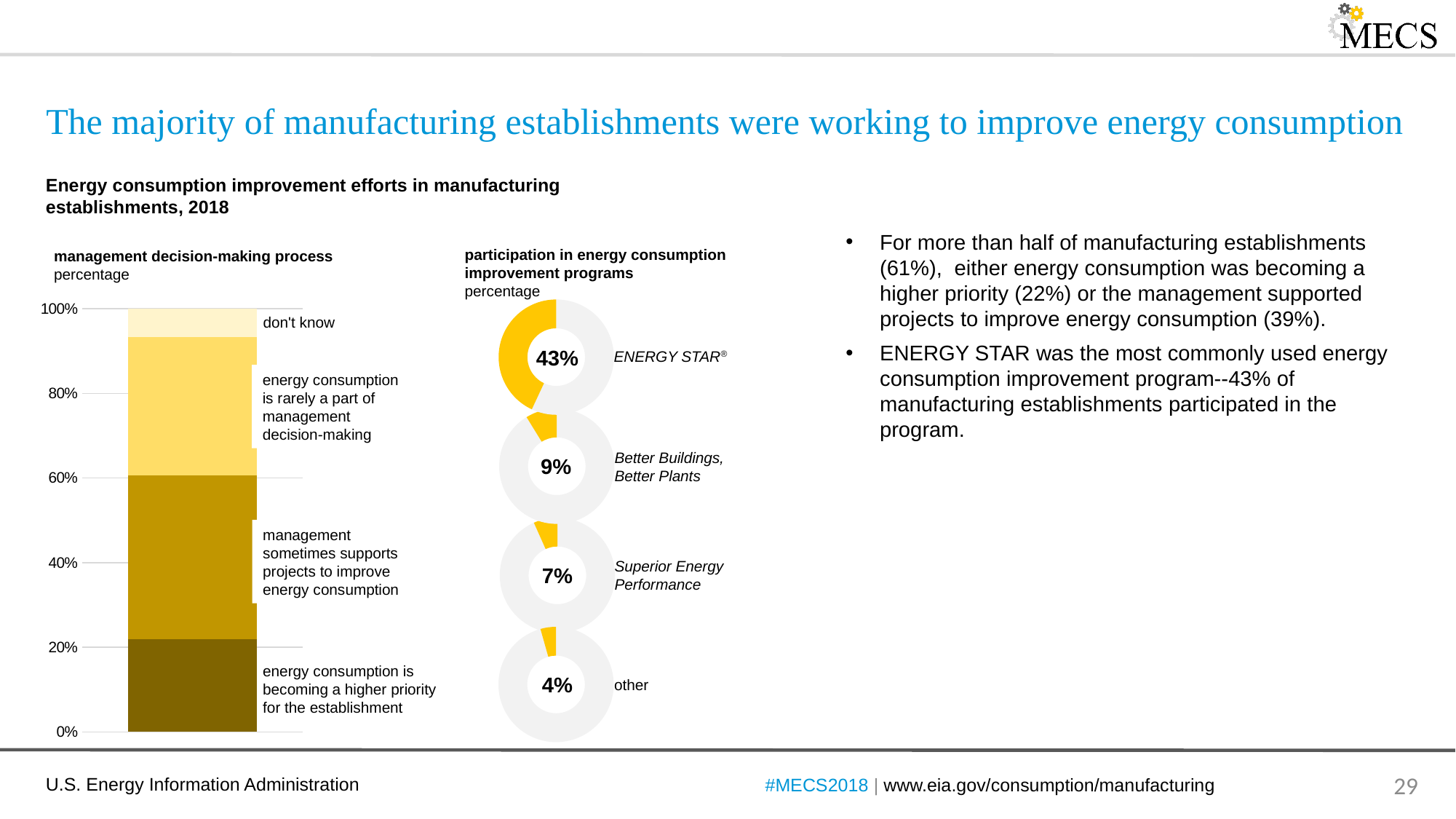
In the participation in energy consumption improvement programs chart, what is the value for Better Buildings, Better Plants? 9% In the participation in energy consumption improvement programs chart, which is larger: Superior Energy Performance or Better Buildings, Better Plants? Better Buildings, Better Plants What kind of chart is the management decision-making process chart? stacked bar chart How many segments make up the bar in the management decision-making process chart? 4 In the participation in energy consumption improvement programs chart, what is the difference between the ENERGY STAR value and the Better Buildings, Better Plants value? 34% In the participation in energy consumption improvement programs chart, what percentage of establishments participated in ENERGY STAR? 43% In the participation in energy consumption improvement programs chart, which category has the lowest value? other In the participation in energy consumption improvement programs chart, which program has the highest participation? ENERGY STAR In the participation in energy consumption improvement programs chart, what is the value for 'other'? 4% In the participation in energy consumption improvement programs chart, what is the value for Superior Energy Performance? 7% How many programs are shown in the participation in energy consumption improvement programs chart? 4 In the management decision-making process chart, is the 'don't know' segment greater or less than 20% of the bar? less